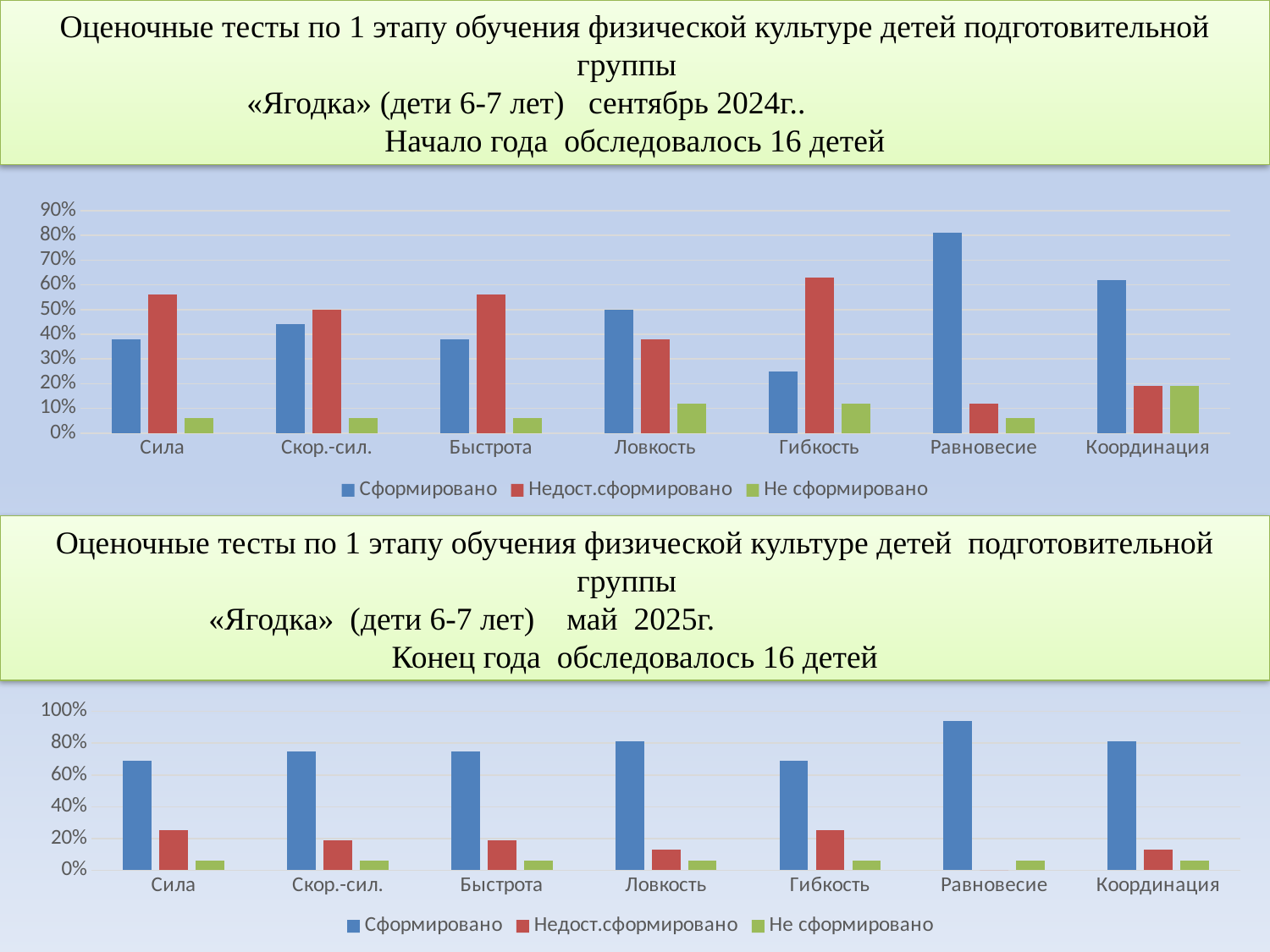
In the top chart (сентябрь 2024), which category has the highest value for Сформировано? Равновесие In the bottom chart (май 2025), which category has the highest value for Сформировано? Равновесие In the top chart (сентябрь 2024), which category has the lowest value for Сформировано? Гибкость In the bottom chart (май 2025), what colour represents the series Сформировано? blue In the top chart (сентябрь 2024), which is larger for Сила: Сформировано or Недост.сформировано? Недост.сформировано In the top chart (сентябрь 2024), is the Сформировано value for Гибкость greater or less than 30%? less In the top chart (сентябрь 2024), is the Недост.сформировано value for Гибкость greater or less than 50%? greater In the bottom chart (май 2025), is the Недост.сформировано value for Ловкость greater or less than 20%? less What kind of chart is the bottom chart (май 2025)? bar chart How many categories are shown on the x axis of the top chart (сентябрь 2024)? 7 How many series does the legend of the top chart (сентябрь 2024) list? 3